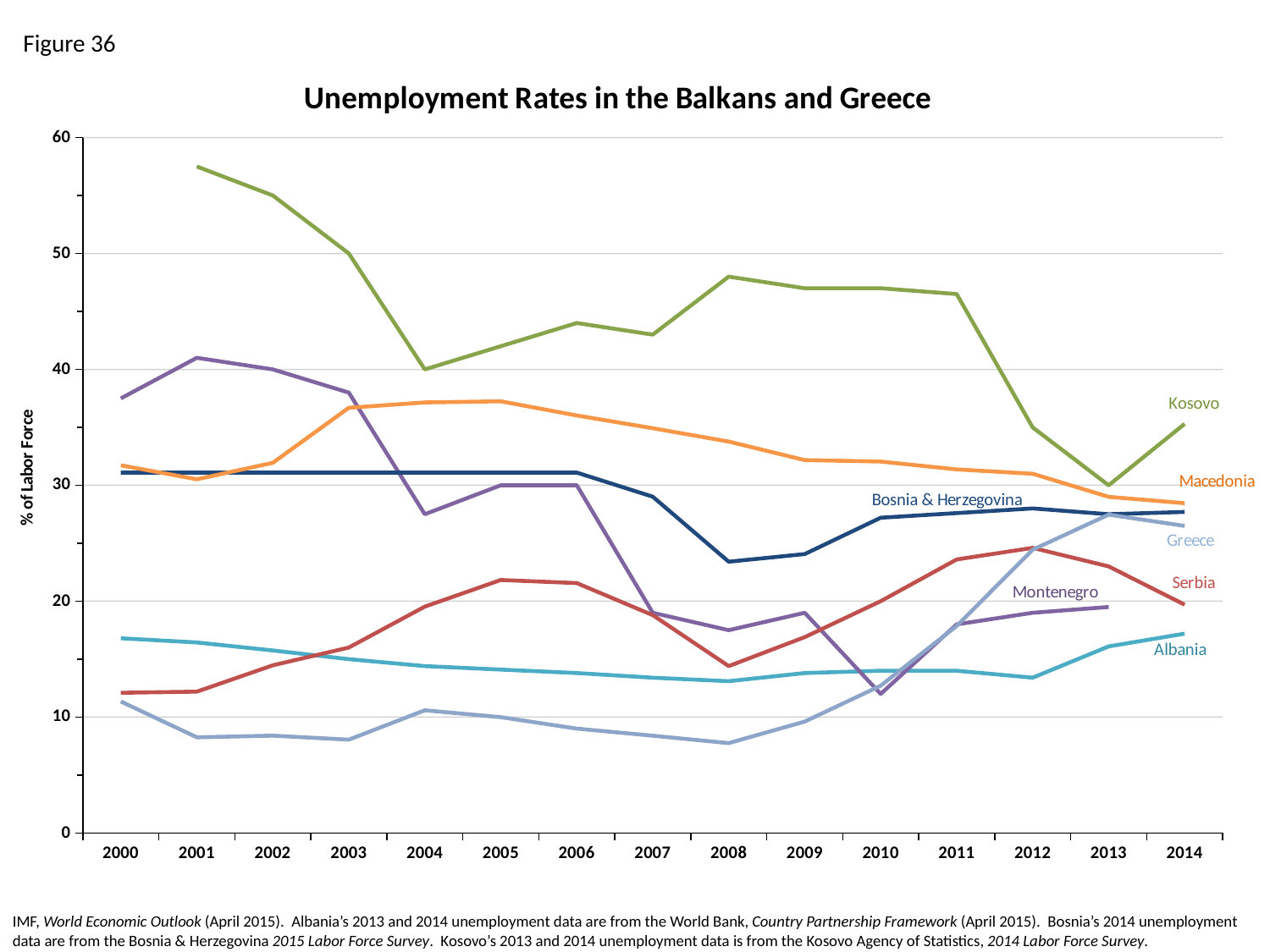
What is the title of the chart? Unemployment Rates in the Balkans and Greece Which country has the highest unemployment rate in 2001? Kosovo What is the label on the y axis of the chart? % of Labor Force Is the unemployment rate for Greece in 2008 greater or less than 10? less Is the unemployment rate for Macedonia in 2014 greater or less than 30? less How many countries are plotted as lines on the chart? 7 Which country has the lowest unemployment rate in 2008? Greece Does the unemployment rate for Kosovo rise or fall between 2001 and 2013? fall How many years are shown along the x axis? 15 What kind of chart is shown on the slide? line chart Is the unemployment rate for Kosovo in 2001 greater or less than 50? greater In 2012, which has the higher unemployment rate, Serbia or Albania? Serbia